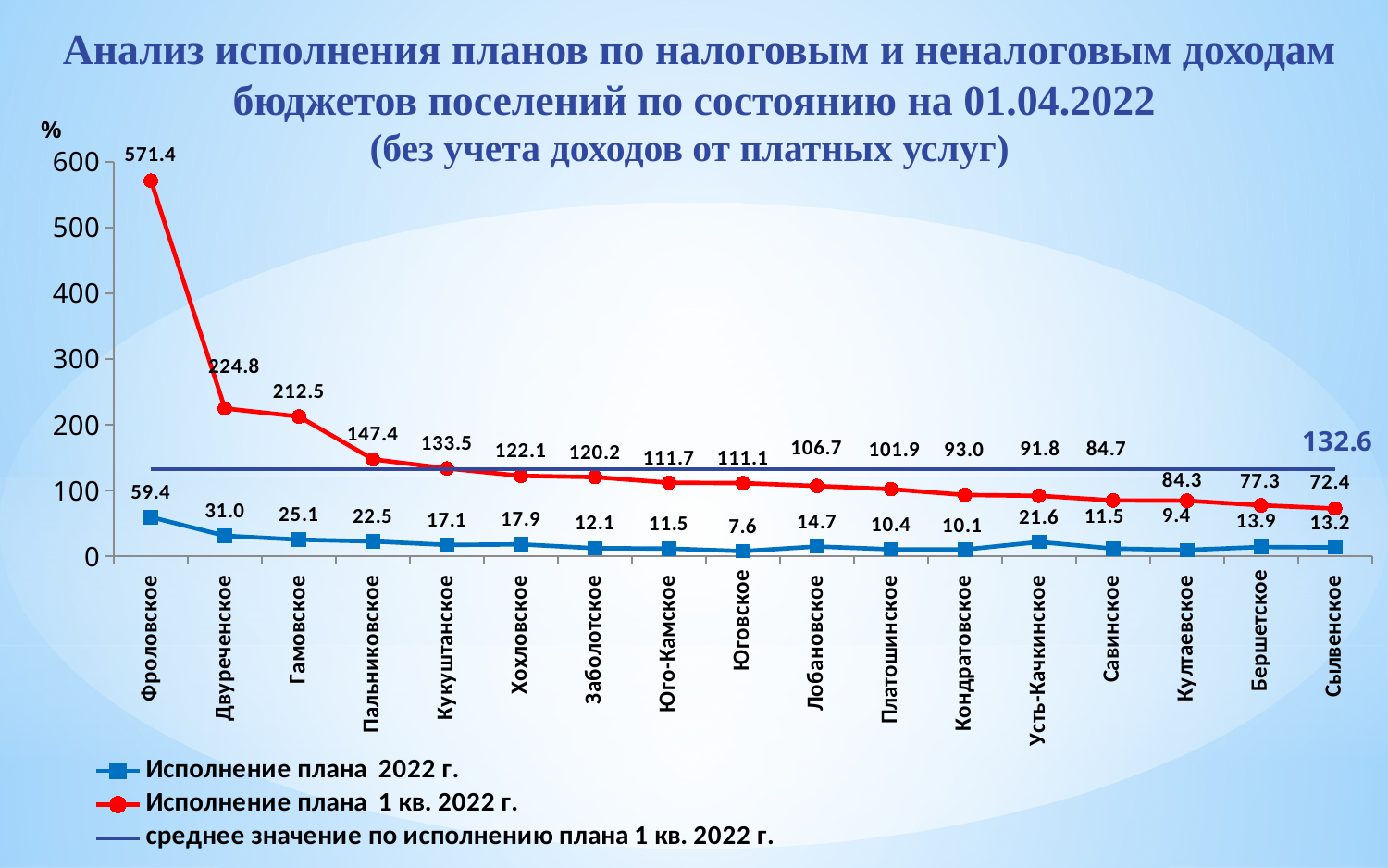
What is the value of the line "среднее значение по исполнению плана 1 кв. 2022 г."? 132.6 Does the series "Исполнение плана 1 кв. 2022 г." rise or fall from left to right along the x axis? Fall What is the difference between the "Исполнение плана 1 кв. 2022 г." values for Двуреченское and Гамовское? 12.3 How many entries does the legend list? 3 Which series is drawn with the blue line and square markers? Исполнение плана 2022 г. In the series "Исполнение плана 2022 г.", which is larger: Хохловское or Кукуштанское? Хохловское How many settlements are shown on the x axis? 17 What is the value for Усть-Качкинское in the series "Исполнение плана 2022 г."? 21.6 Which settlement has the highest value in the series "Исполнение плана 1 кв. 2022 г."? Фроловское What is the value for Фроловское in the series "Исполнение плана 1 кв. 2022 г."? 571.4 Which settlement has the lowest value in the series "Исполнение плана 2022 г."? Юговское What kind of chart is shown on the slide? Line chart